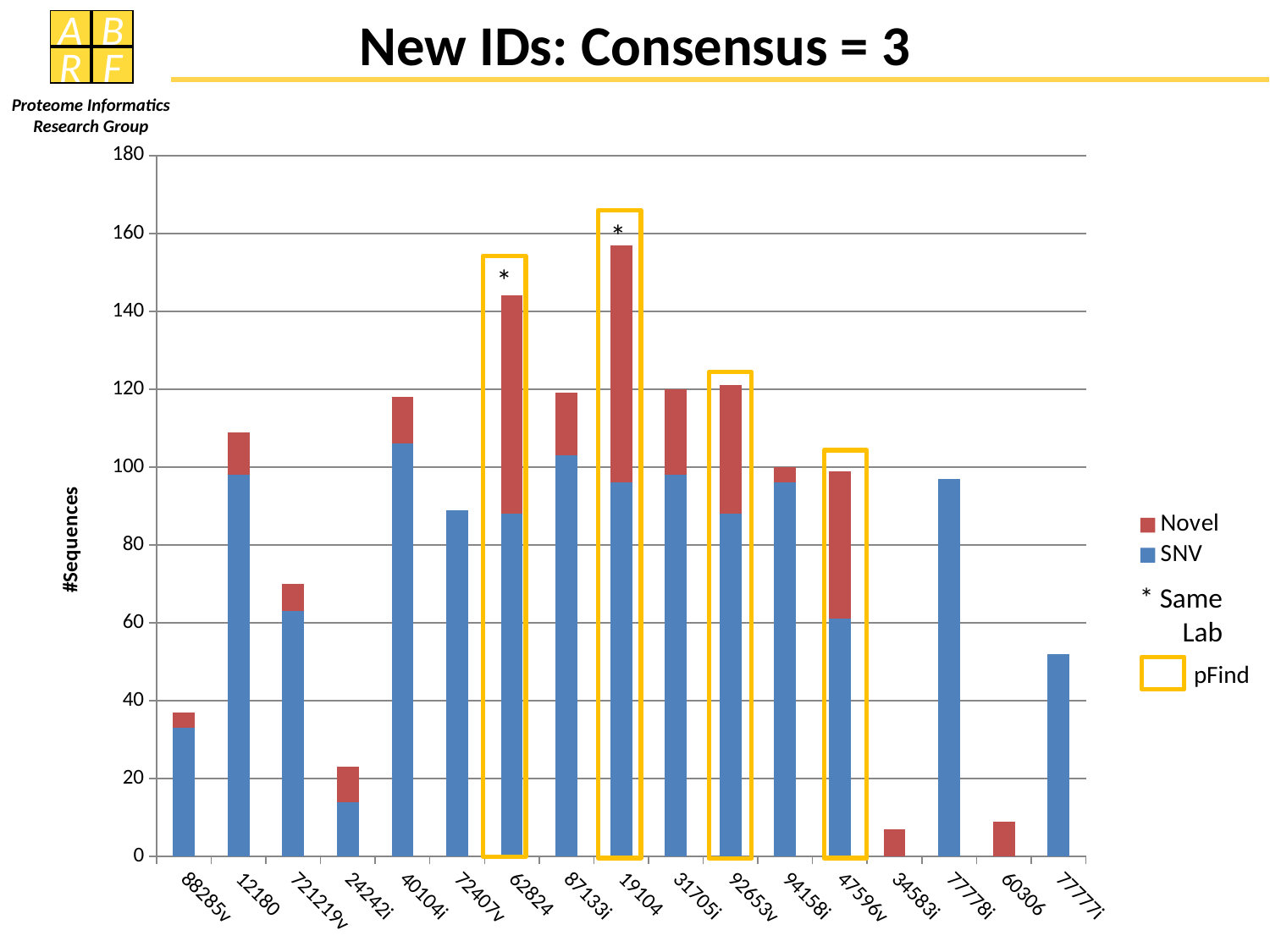
Which has a larger total, 12180 or 721219v? 12180 How many categories are shown on the x axis? 17 Is the total value for 72407v greater or less than 100? less How many series does the legend list? 2 Is the value for 77777i greater or less than 60? less According to the legend, what do the yellow boxes around bars indicate? pFind Which category has the highest total number of sequences? 19104 Is the total value for 88285v greater or less than 40? less What kind of chart is shown on the slide? Stacked bar chart Which has a larger total, 62824 or 19104? 19104